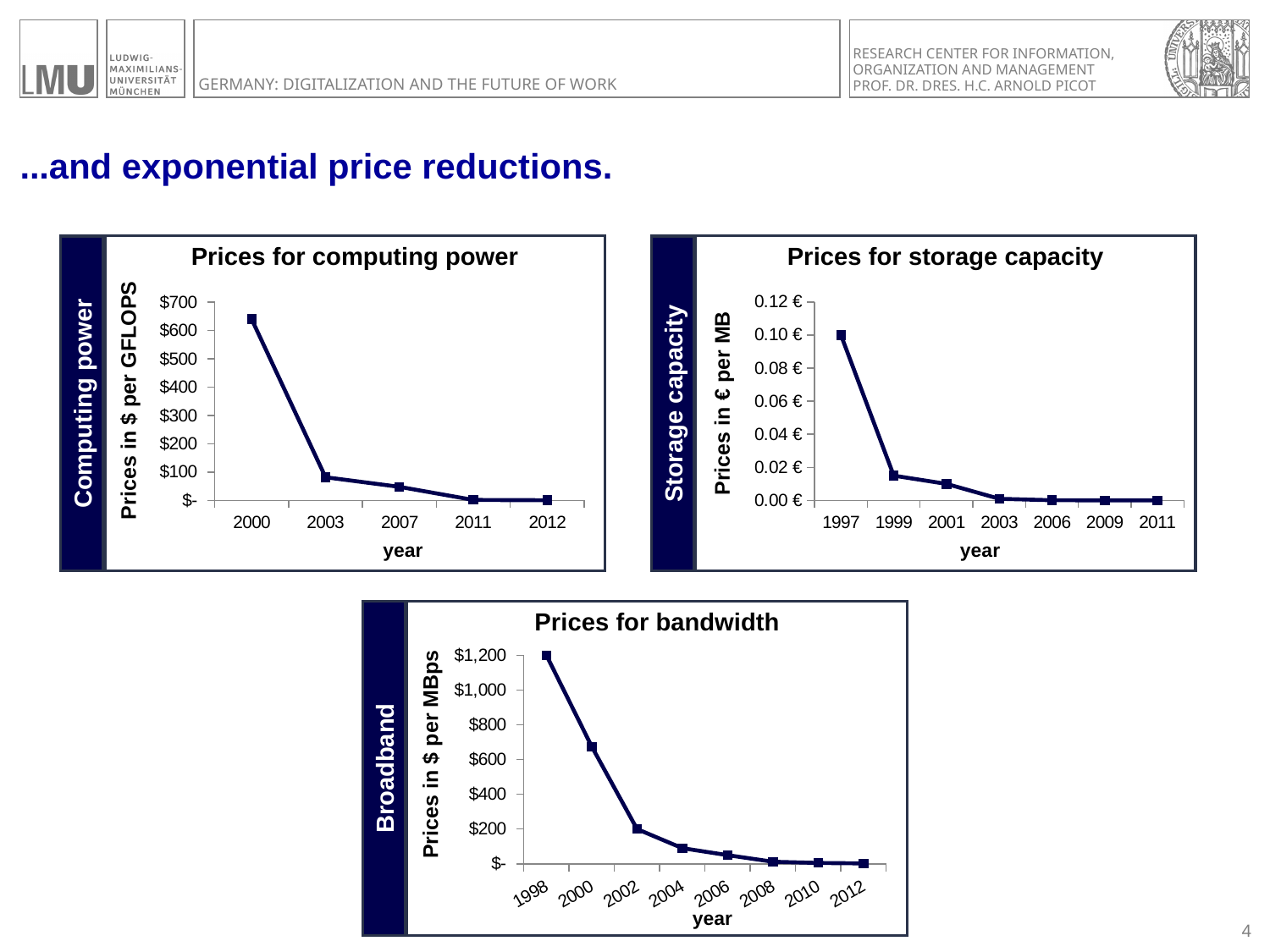
In the 'Prices for computing power' chart, how many years are plotted on the x axis? 5 What is the y-axis label of the 'Prices for bandwidth' chart? Prices in $ per MBps What kind of chart is the 'Prices for computing power' chart? line chart In the 'Prices for computing power' chart, which year has the highest price? 2000 In the 'Prices for bandwidth' chart, which is larger, the value for 2000 or the value for 2002? 2000 In the 'Prices for storage capacity' chart, how many years are plotted on the x axis? 7 In the 'Prices for computing power' chart, is the value for 2003 greater or less than $100? less In the 'Prices for computing power' chart, is the value for 2000 greater or less than $600? greater In the 'Prices for bandwidth' chart, what is the price per MBps in 1998? $1,200 In the 'Prices for computing power' chart, do prices rise or fall from 2000 to 2012? fall In the 'Prices for storage capacity' chart, what is the price per MB in 1997? 0.10 € In the 'Prices for storage capacity' chart, is the value for 1999 greater or less than 0.02 €? less